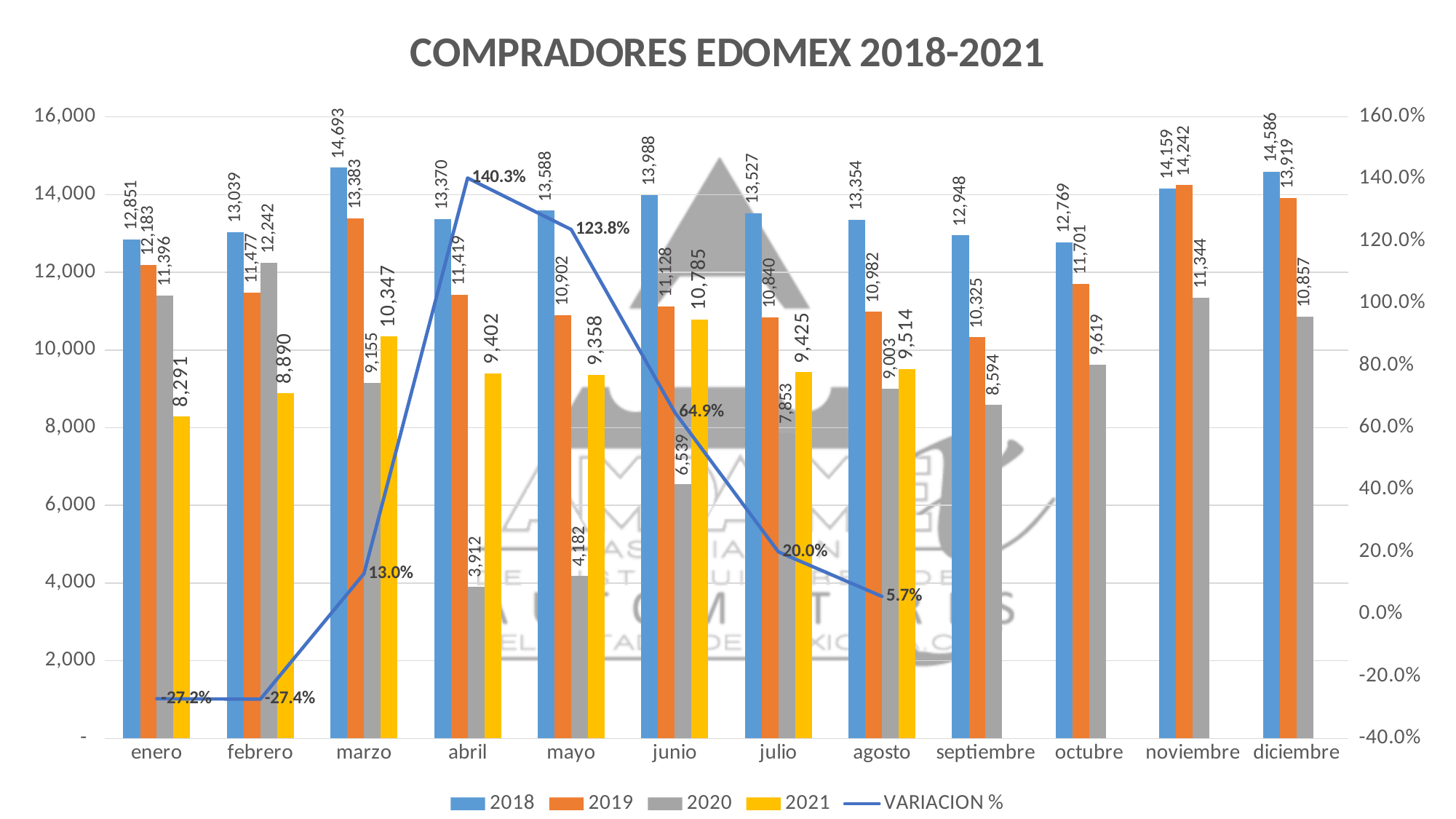
How many months are shown on the x axis? 12 What is the difference between the 2018 and 2019 values for enero? 668 What kind of chart is this? Bar chart with a line Which month has the highest 2018 value? marzo Which month has the highest 2021 value? junio What is the VARIACION % value for mayo? 123.8% For noviembre, which is larger: the 2018 value or the 2019 value? 2019 Does the VARIACION % line rise or fall from abril to agosto? Fall What is the 2021 value for junio? 10,785 How many series does the legend list? 5 Which month has the lowest 2020 value? abril What is the 2020 value for abril? 3,912